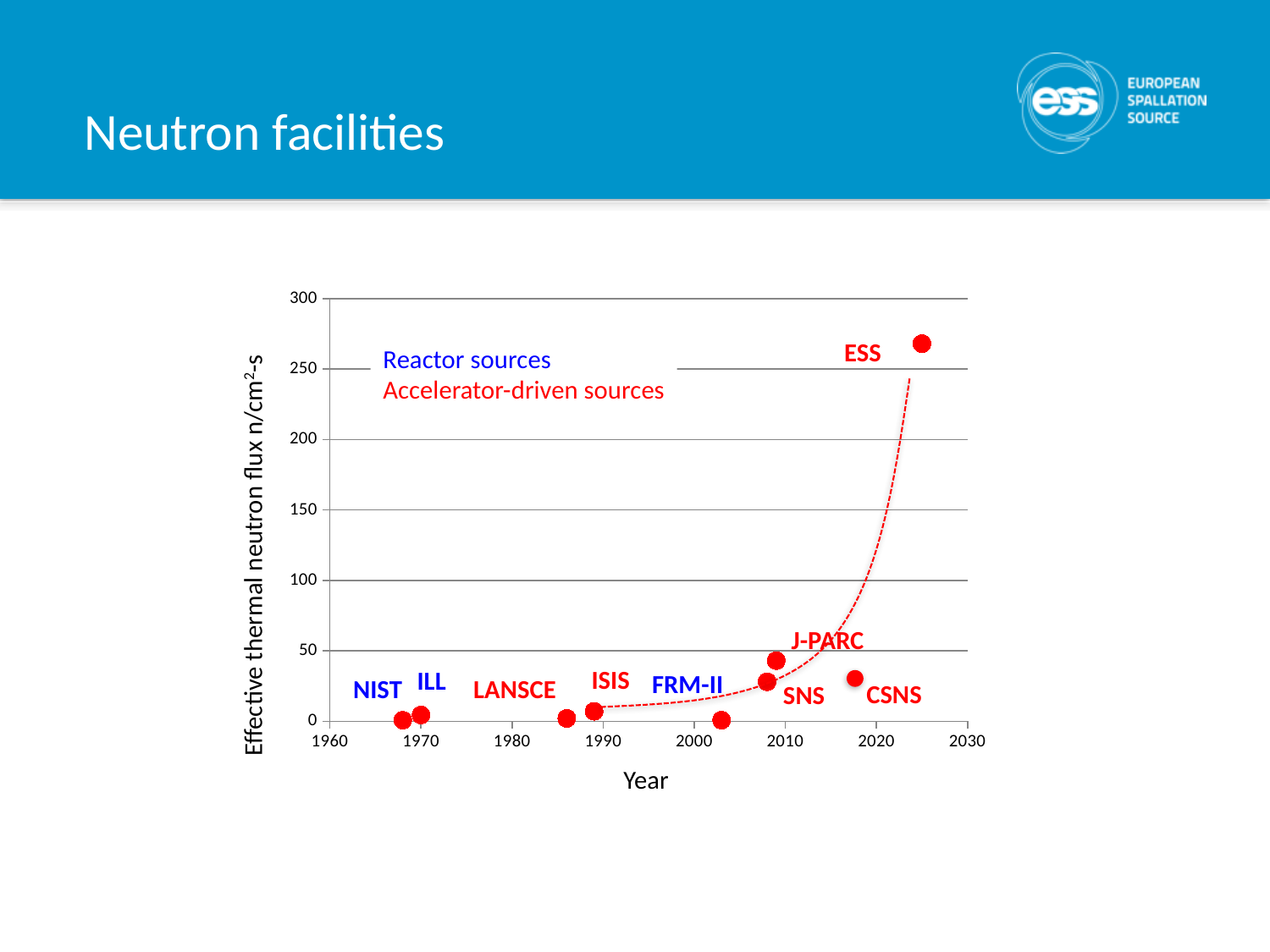
What colour is used for the labels of reactor sources? blue Which has a higher effective thermal neutron flux, J-PARC or SNS? J-PARC Is the value for CSNS greater or less than 100? less How many facilities are plotted on the chart? 9 Is the value for ESS greater or less than 250? greater Is the value for NIST greater or less than 50? less What kind of chart is shown on the slide? scatter chart Which facility has the highest effective thermal neutron flux? ESS Do the plotted values generally rise or fall as the year increases? rise Which has a higher effective thermal neutron flux, ESS or J-PARC? ESS What is the label of the x axis? Year